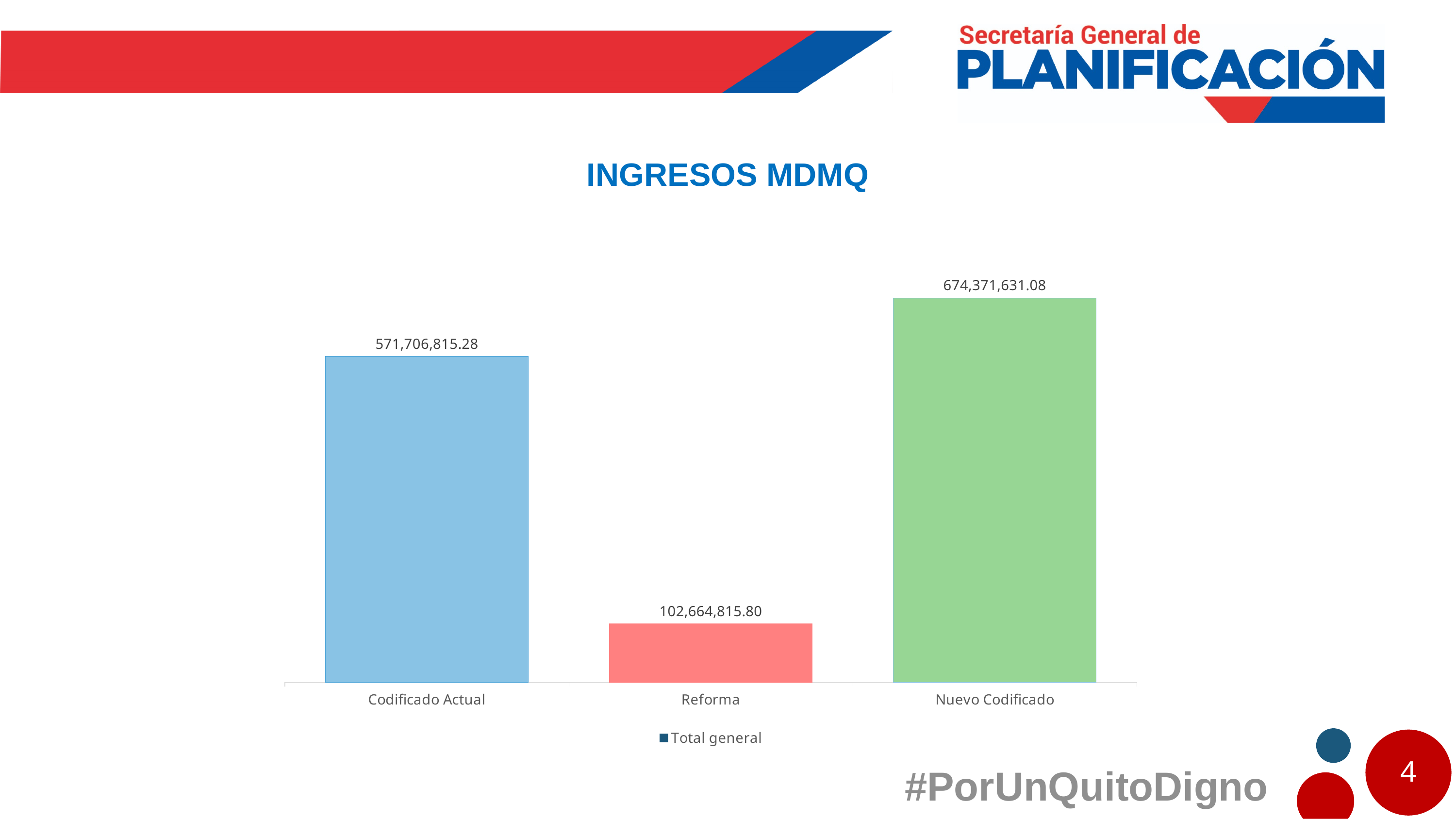
What is the value for Codificado Actual? 571,706,815.28 How many series does the legend list? 1 What is the value for Nuevo Codificado? 674,371,631.08 What is the difference between the values for Nuevo Codificado and Codificado Actual? 102,664,815.80 What kind of chart is shown on the slide? Bar chart How many categories are shown on the x axis? 3 Which category has the highest value? Nuevo Codificado Which is larger, the value for Codificado Actual or the value for Reforma? Codificado Actual What is the value for Reforma? 102,664,815.80 What is the title of the chart? INGRESOS MDMQ Which category has the lowest value? Reforma What is the difference between the values for Codificado Actual and Reforma? 469,041,999.48